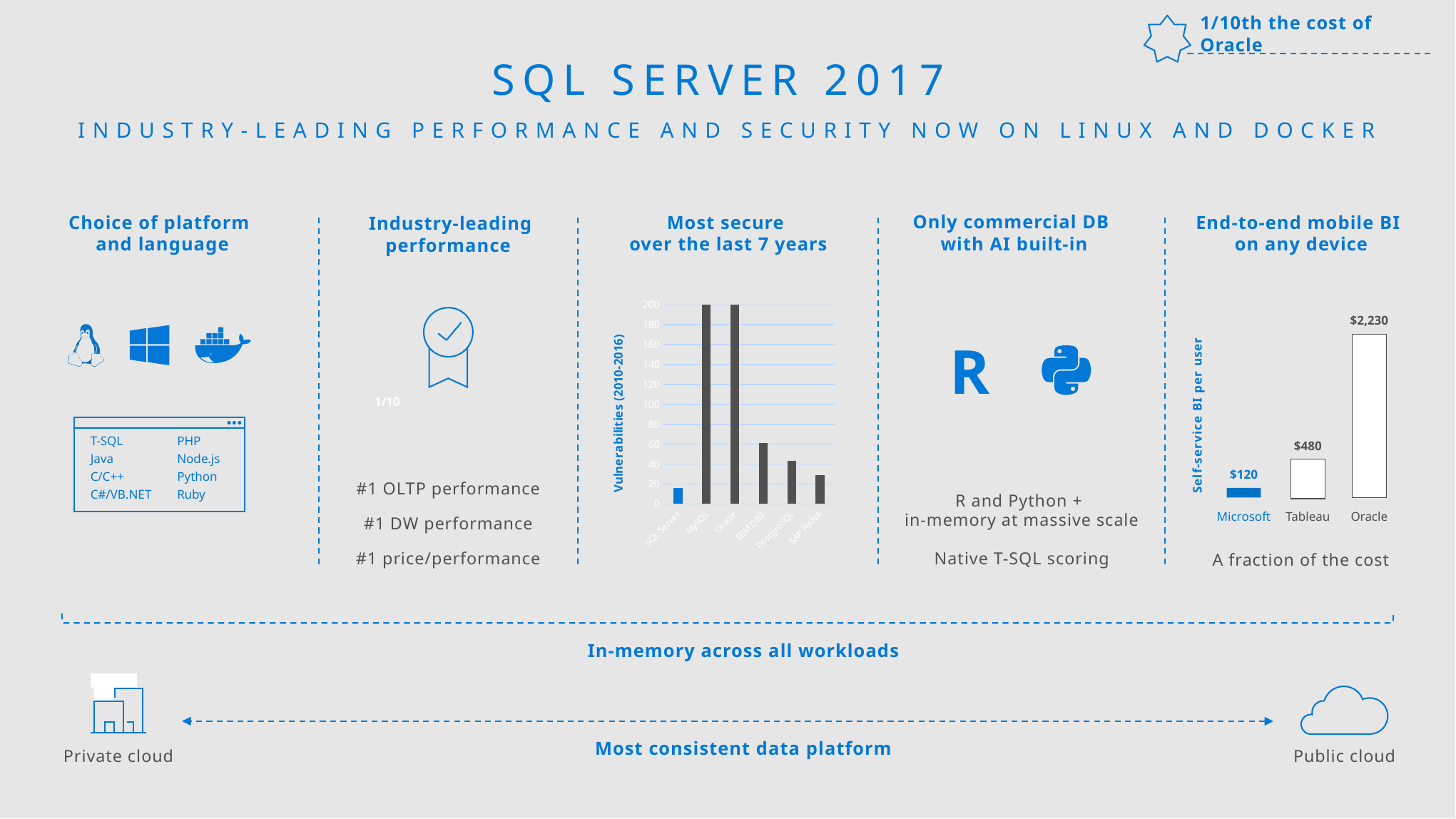
In the 'Self-service BI per user' chart, which category has the lowest value? Microsoft In the 'Self-service BI per user' chart, what is the value for Tableau? $480 In the 'Vulnerabilities (2010-2016)' chart, is the value for IBM DB2 greater or less than 40? greater In the 'Self-service BI per user' chart, what is the difference between the Tableau and Microsoft values? $360 In the 'Self-service BI per user' chart, which category has the highest value? Oracle In the 'Vulnerabilities (2010-2016)' chart, which database has the lowest number of vulnerabilities? SQL Server In the 'Self-service BI per user' chart, what is the value for Oracle? $2,230 In the 'Self-service BI per user' chart, what is the difference between the Oracle and Tableau values? $1,750 In the 'Self-service BI per user' chart, what is the value for Microsoft? $120 How many categories are shown in the 'Self-service BI per user' chart? 3 How many databases are shown in the 'Vulnerabilities (2010-2016)' chart? 6